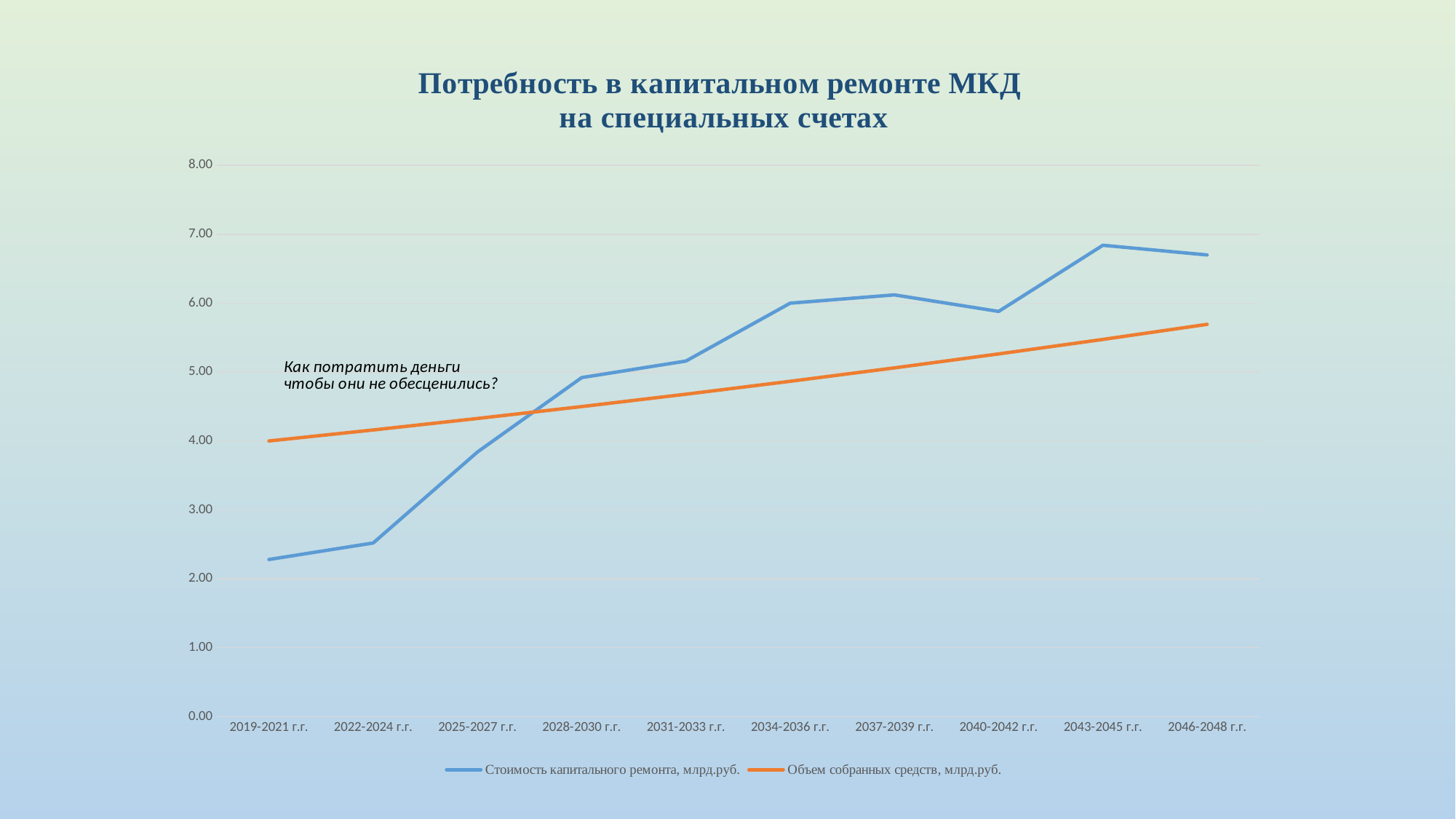
Is the value of 'Стоимость капитального ремонта, млрд.руб.' for 2043-2045 г.г. greater or less than 6.00? greater Is the value of 'Объем собранных средств, млрд.руб.' for 2046-2048 г.г. greater or less than 6.00? less What kind of chart is shown on the slide? Line chart In which period is the value of 'Стоимость капитального ремонта, млрд.руб.' lowest? 2019-2021 г.г. What is the title of the chart? Потребность в капитальном ремонте МКД на специальных счетах Is the value of 'Стоимость капитального ремонта, млрд.руб.' for 2019-2021 г.г. greater or less than 3.00? less Which series has the higher value in 2046-2048 г.г.? Стоимость капитального ремонта, млрд.руб. In which period is the value of 'Объем собранных средств, млрд.руб.' highest? 2046-2048 г.г. How many series does the legend list? 2 Does the 'Объем собранных средств, млрд.руб.' line rise or fall from 2019-2021 г.г. to 2046-2048 г.г.? Rises Which series has the higher value in 2019-2021 г.г.? Объем собранных средств, млрд.руб. How many time periods are shown on the x axis? 10